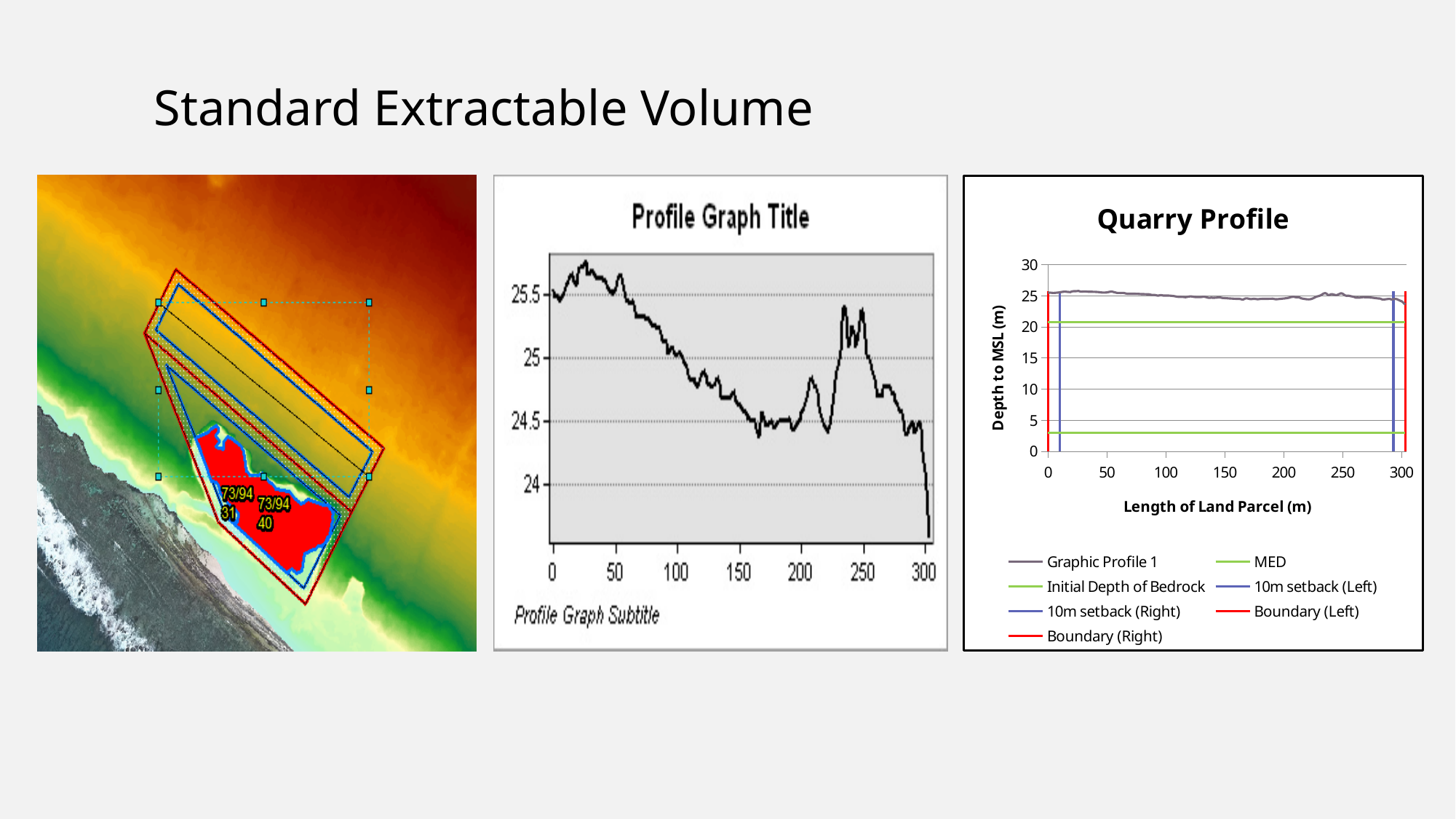
In the chart titled Profile Graph Title, is the value at x = 150 greater or less than 25? less What kind of chart is the Quarry Profile chart? line chart What is the x-axis label of the Quarry Profile chart? Length of Land Parcel (m) What is the y-axis label of the Quarry Profile chart? Depth to MSL (m) In the chart titled Profile Graph Title, is the value at x = 0 greater or less than 25? greater In the chart titled Profile Graph Title, do the values generally rise or fall from 0 to 300 along the x axis? fall In the Quarry Profile chart, is the value of Graphic Profile 1 at 200 m greater or less than 30? less In the Quarry Profile chart, is the value of Graphic Profile 1 at 50 m larger or smaller than its value at 150 m? larger What kind of chart is the chart titled Profile Graph Title? line chart How many series does the legend of the Quarry Profile chart list? 7